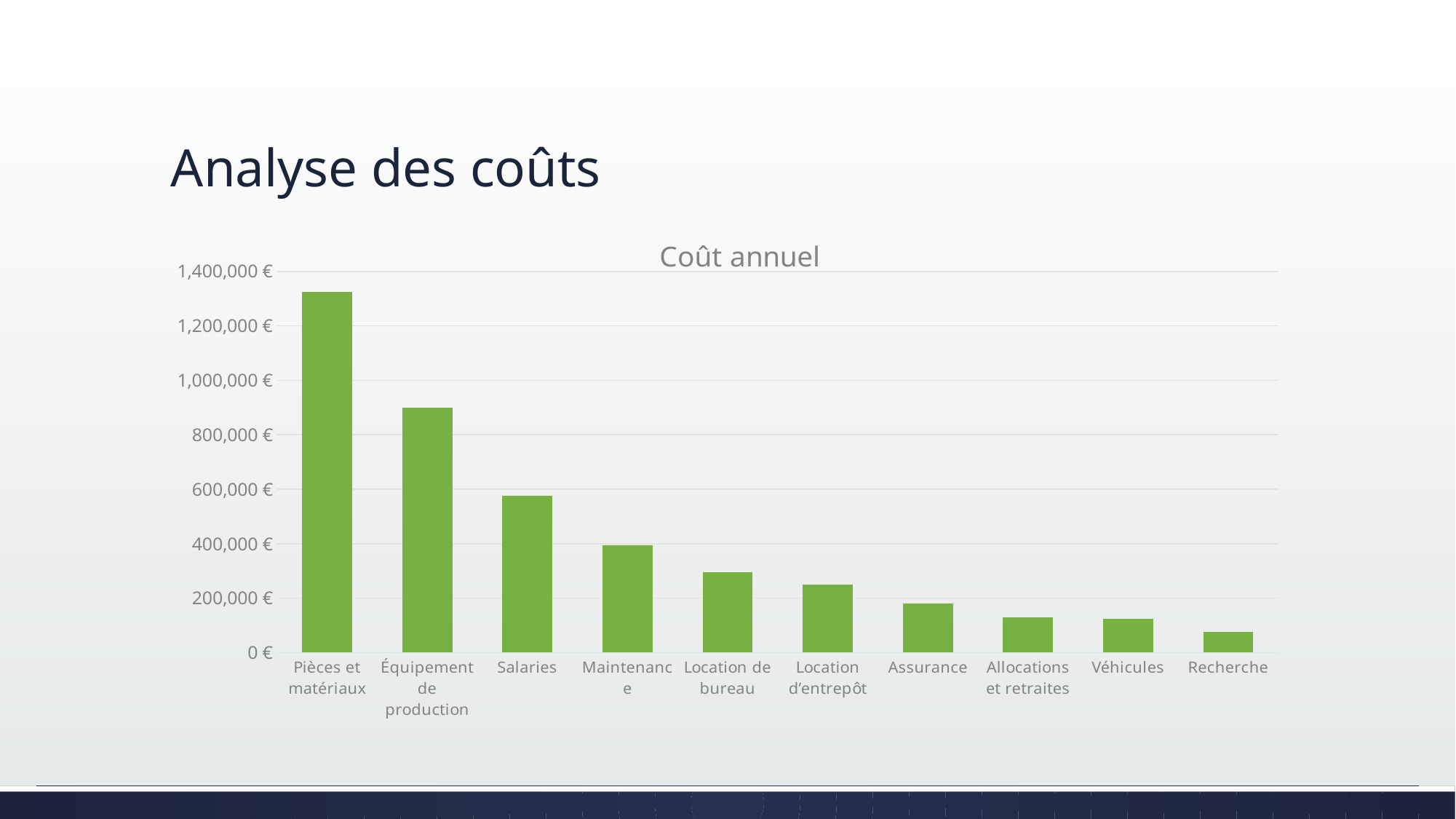
What is the title of the chart? Coût annuel Is the value for Salaries greater or less than 400,000 €? greater What kind of chart is shown on the slide? bar chart Which is larger, the cost for Salaries or the cost for Maintenance? Salaries Which category has the highest annual cost? Pièces et matériaux Is the value for Pièces et matériaux greater or less than 1,200,000 €? greater Is the value for Équipement de production greater or less than 1,000,000 €? less Which category has the lowest annual cost? Recherche Do the values rise or fall from left to right along the x axis? fall What colour are the bars in the chart? green How many cost categories are plotted in the chart? 10